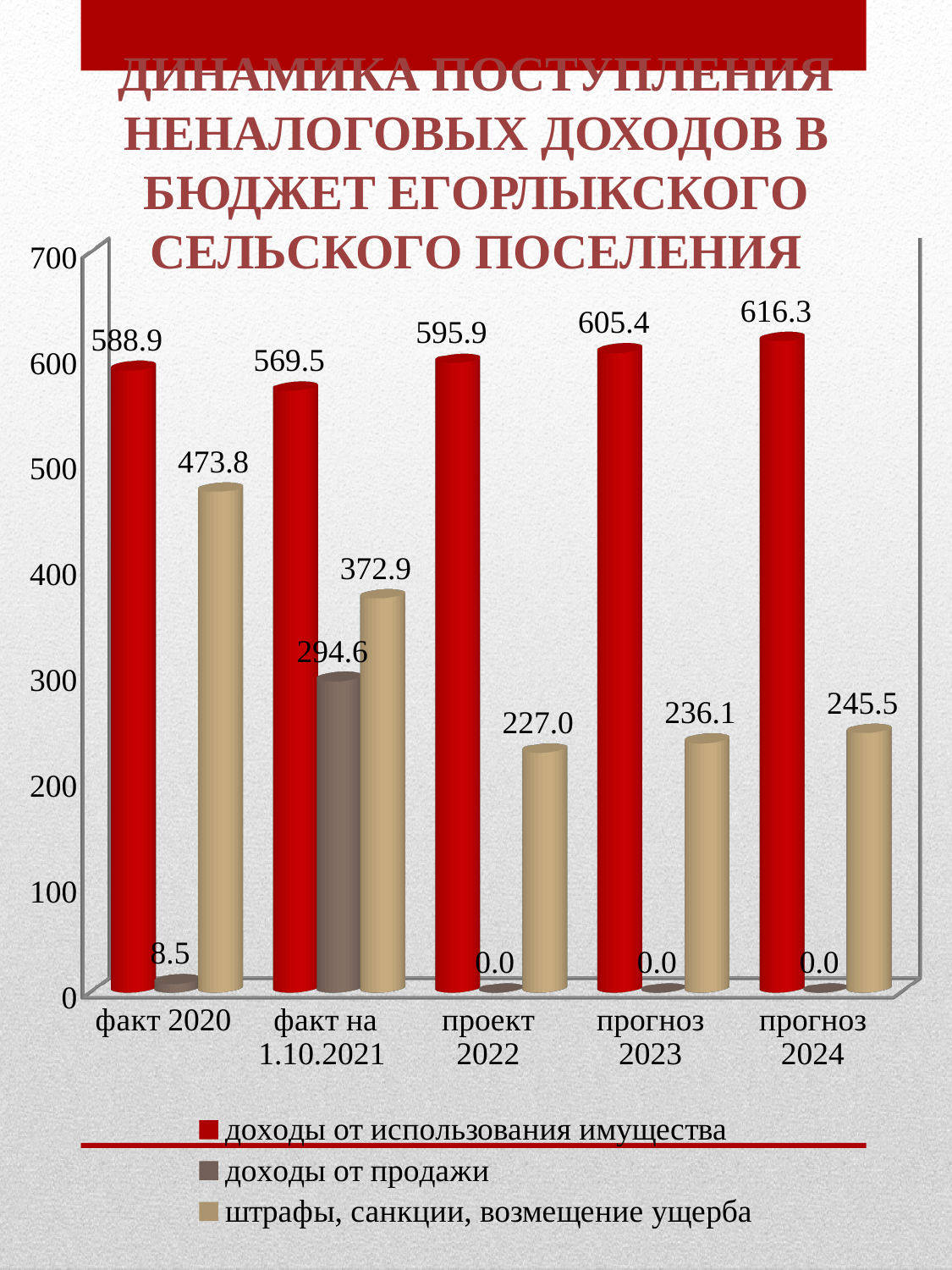
Which category has the lowest value for штрафы, санкции, возмещение ущерба? проект 2022 How many series does the legend list? 3 What is the value for доходы от использования имущества in прогноз 2024? 616.3 What kind of chart is shown on the slide? bar chart What colour represents доходы от продажи in the legend? brown How many categories are shown on the x axis? 5 What is the value for доходы от продажи in факт на 1.10.2021? 294.6 Do the values for доходы от использования имущества rise or fall from проект 2022 to прогноз 2024? rise What is the difference between доходы от использования имущества in прогноз 2024 and in прогноз 2023? 10.9 Which category has the highest value for доходы от использования имущества? прогноз 2024 Which is larger: штрафы, санкции, возмещение ущерба in факт 2020 or in факт на 1.10.2021? факт 2020 What is the value for штрафы, санкции, возмещение ущерба in факт 2020? 473.8